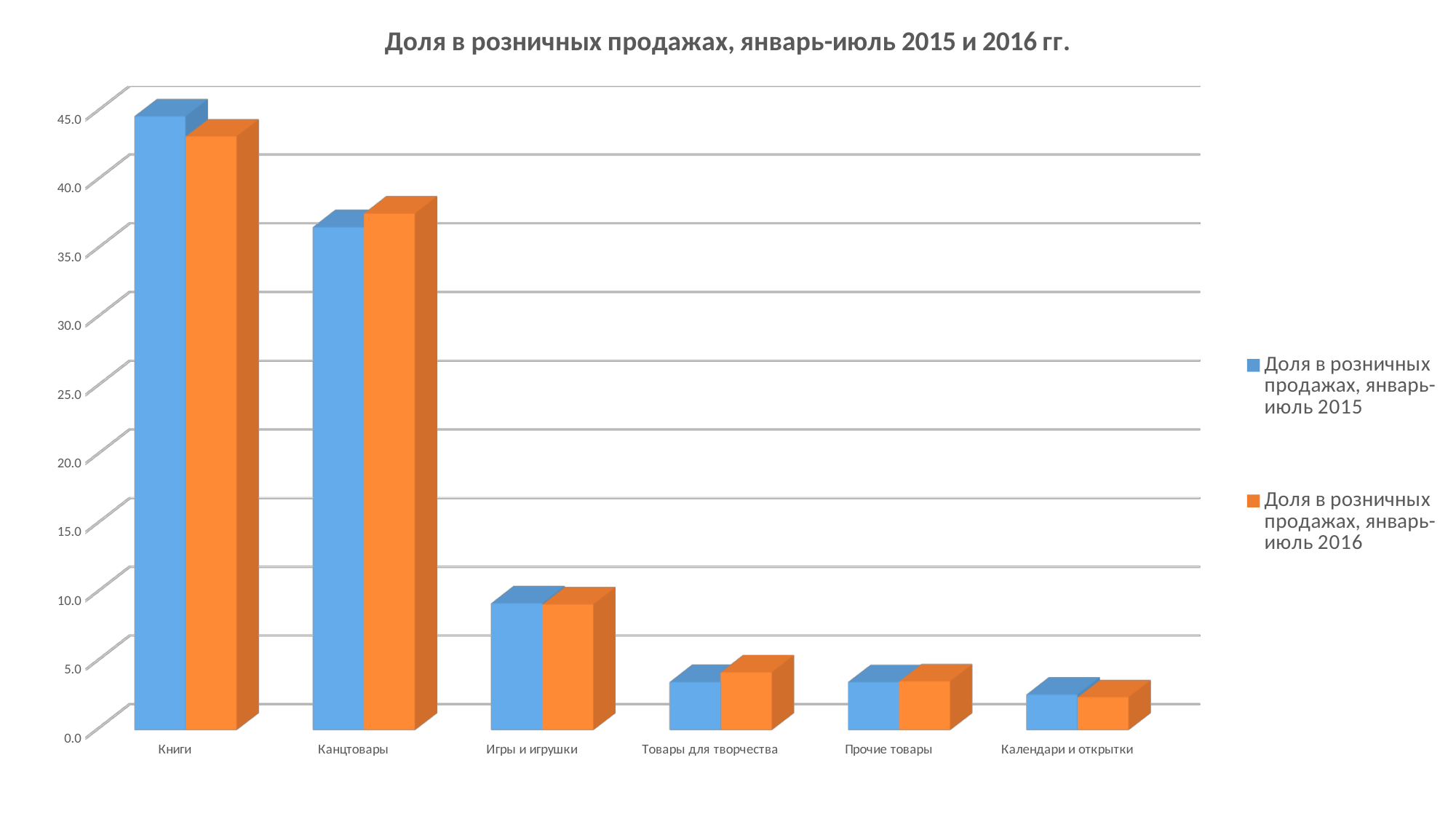
For Канцтовары, which series has the larger value: 'январь-июль 2015' or 'январь-июль 2016'? январь-июль 2016 How many series does the legend list? 2 Which category has the highest value for the series 'Доля в розничных продажах, январь-июль 2015'? Книги Is the value for Книги in the series 'Доля в розничных продажах, январь-июль 2015' greater or less than 40.0? greater What is the title of the chart? Доля в розничных продажах, январь-июль 2015 и 2016 гг. Which category has the lowest value for the series 'Доля в розничных продажах, январь-июль 2016'? Календари и открытки In the series 'Доля в розничных продажах, январь-июль 2015', which is larger: Книги or Канцтовары? Книги What kind of chart is shown on the slide? Bar chart Is the value for Игры и игрушки in the series 'Доля в розничных продажах, январь-июль 2016' greater or less than 10.0? less Is the value for Канцтовары in the series 'Доля в розничных продажах, январь-июль 2016' greater or less than 35.0? greater How many categories are shown on the x axis? 6 Do the values generally rise or fall moving from left to right along the x axis? Fall